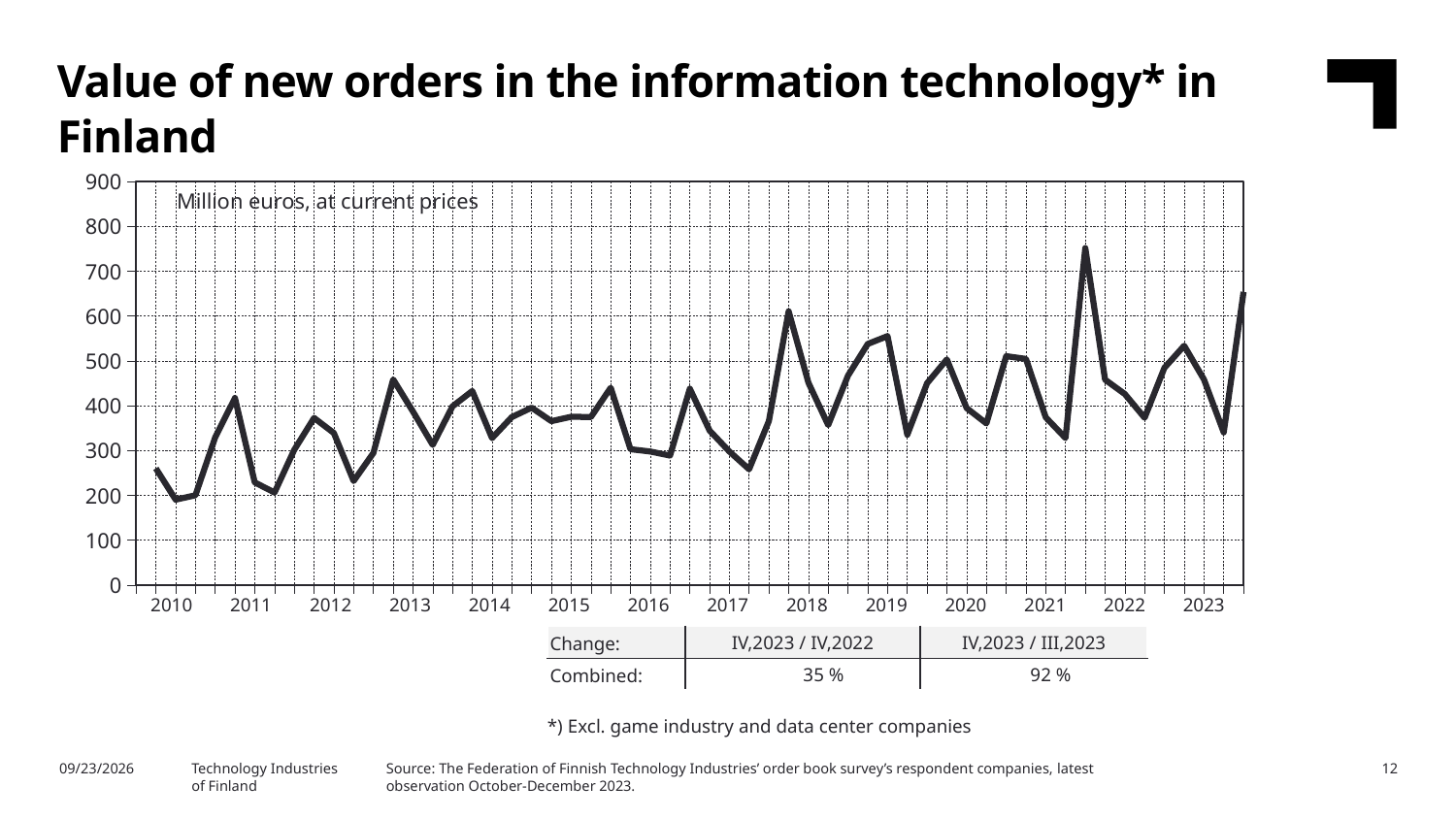
Is the peak of the line in 2018 greater or less than 500? greater What is the title of the chart? Value of new orders in the information technology* in Finland Which is higher: the last value at the end of 2023 or the peak in 2022? end of 2023 In what unit are the values on the chart expressed, according to the label inside the plot area? Million euros, at current prices Which is higher: the peak of the line in 2021 or the peak in 2018? 2021 Is the last plotted value, at the end of 2023, greater or less than 600? greater Is the first plotted value, at the start of 2010, greater or less than 300? less In which year does the line reach its highest peak? 2021 Does the line overall rise or fall from 2010 to 2023? rise What kind of chart is shown on the slide? line chart How many years are labelled on the x axis of the chart? 14